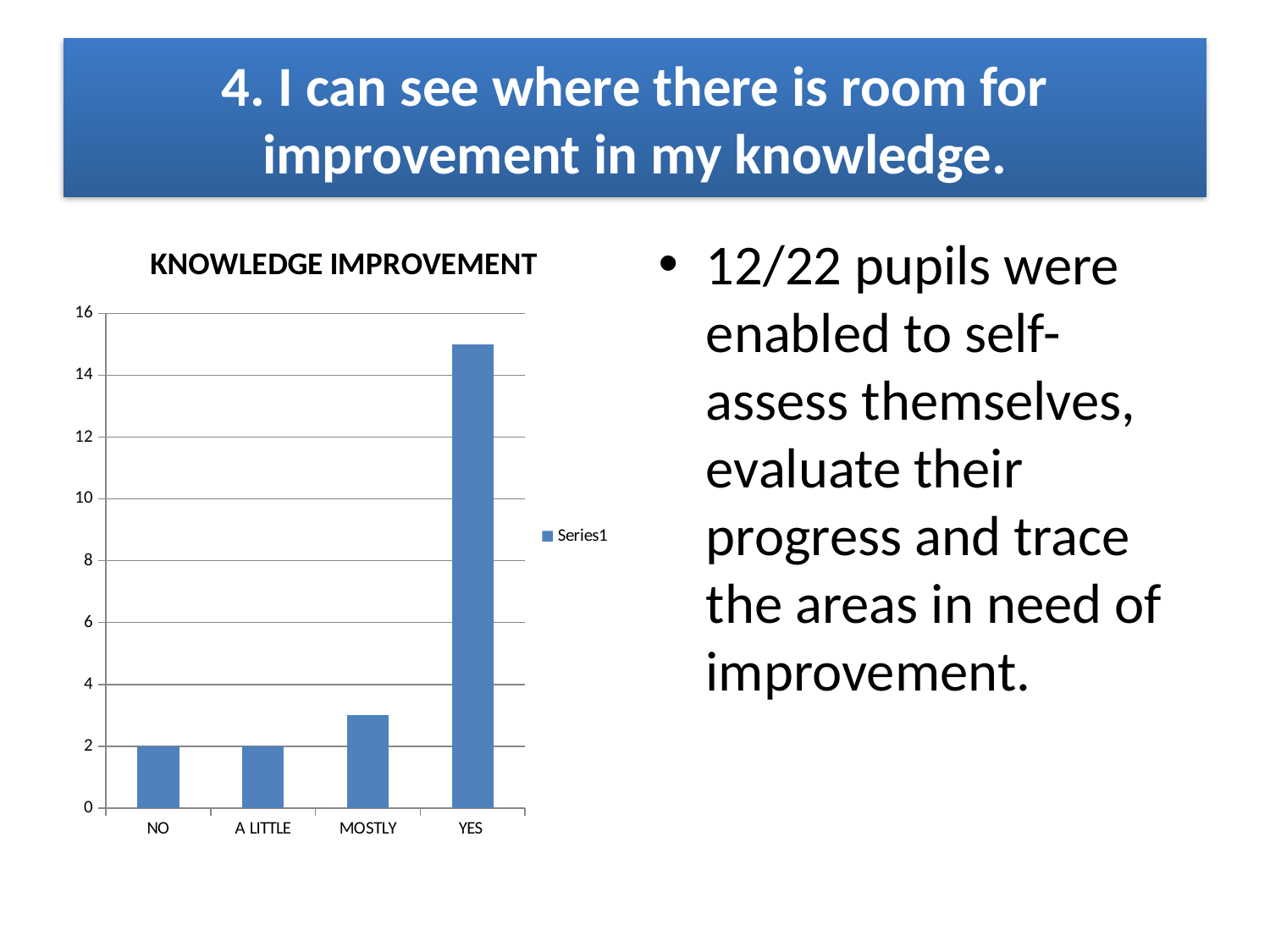
What is the title of the chart? KNOWLEDGE IMPROVEMENT What is the name of the series shown in the legend? Series1 How many series does the chart legend list? 1 Which category has the highest value in the chart? YES What type of chart is shown on the slide? bar chart Which is larger, the value for MOSTLY or the value for YES? YES Is the value for YES greater or less than 14? greater What is the value for NO in the chart? 2 What is the difference between the values for NO and A LITTLE? 0 Is the value for MOSTLY greater or less than 4? less What is the value for A LITTLE in the chart? 2 How many categories are shown on the x axis of the chart? 4